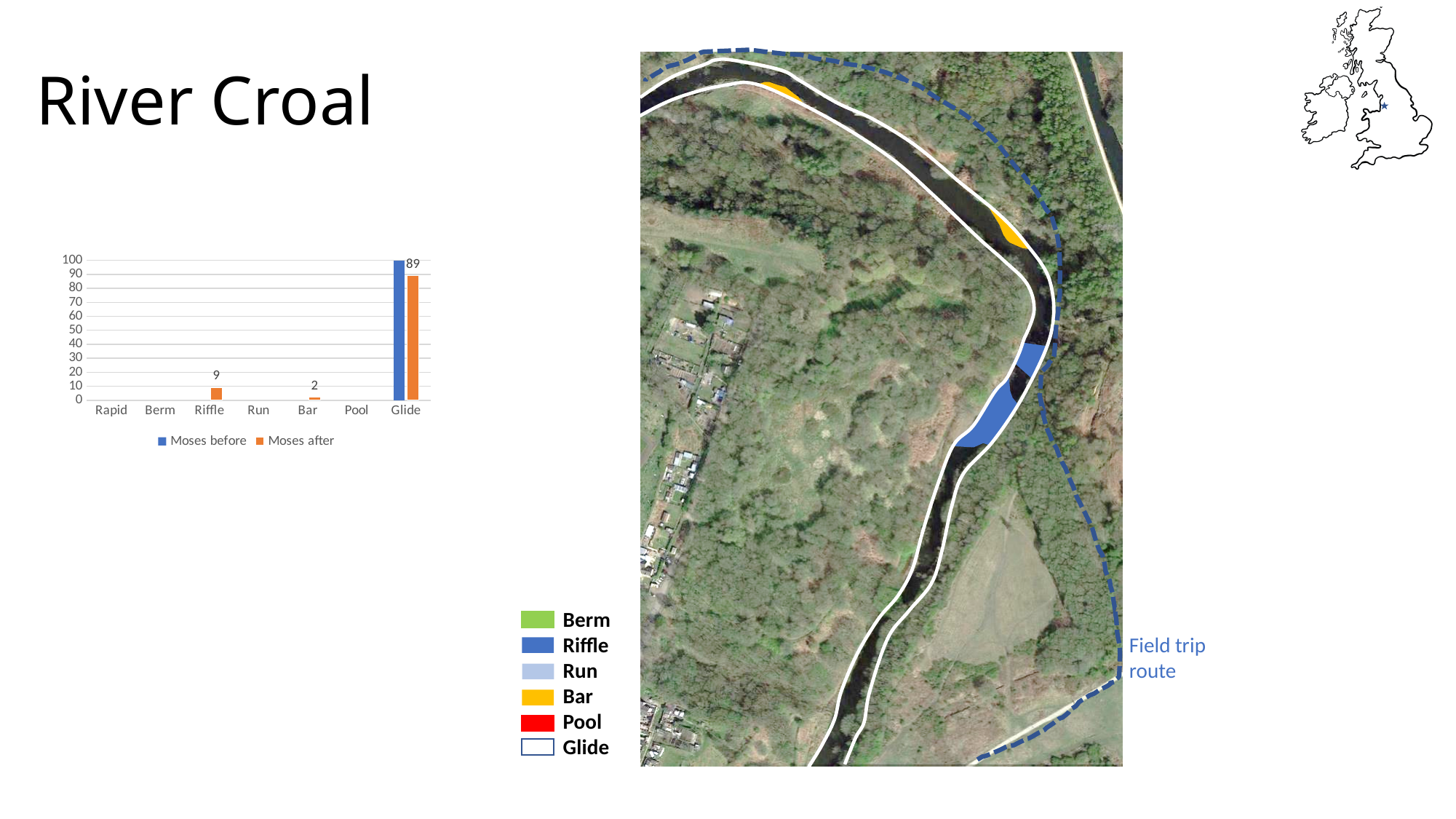
What type of chart is shown on the slide? bar chart What is the Moses after value for Glide? 89 Is the Moses before value for Glide greater or less than 90? greater Which category has the highest Moses after value? Glide Which colour represents the Moses after series in the chart? orange What is the Moses after value for Riffle? 9 What is the Moses after value for Bar? 2 How many categories are shown on the x axis of the chart? 7 Is the Moses after value for Riffle larger or smaller than the Moses after value for Bar? larger How many series does the chart legend list? 2 What are the two series named in the chart legend? Moses before, Moses after What is the difference between the Moses after values for Glide and Riffle? 80